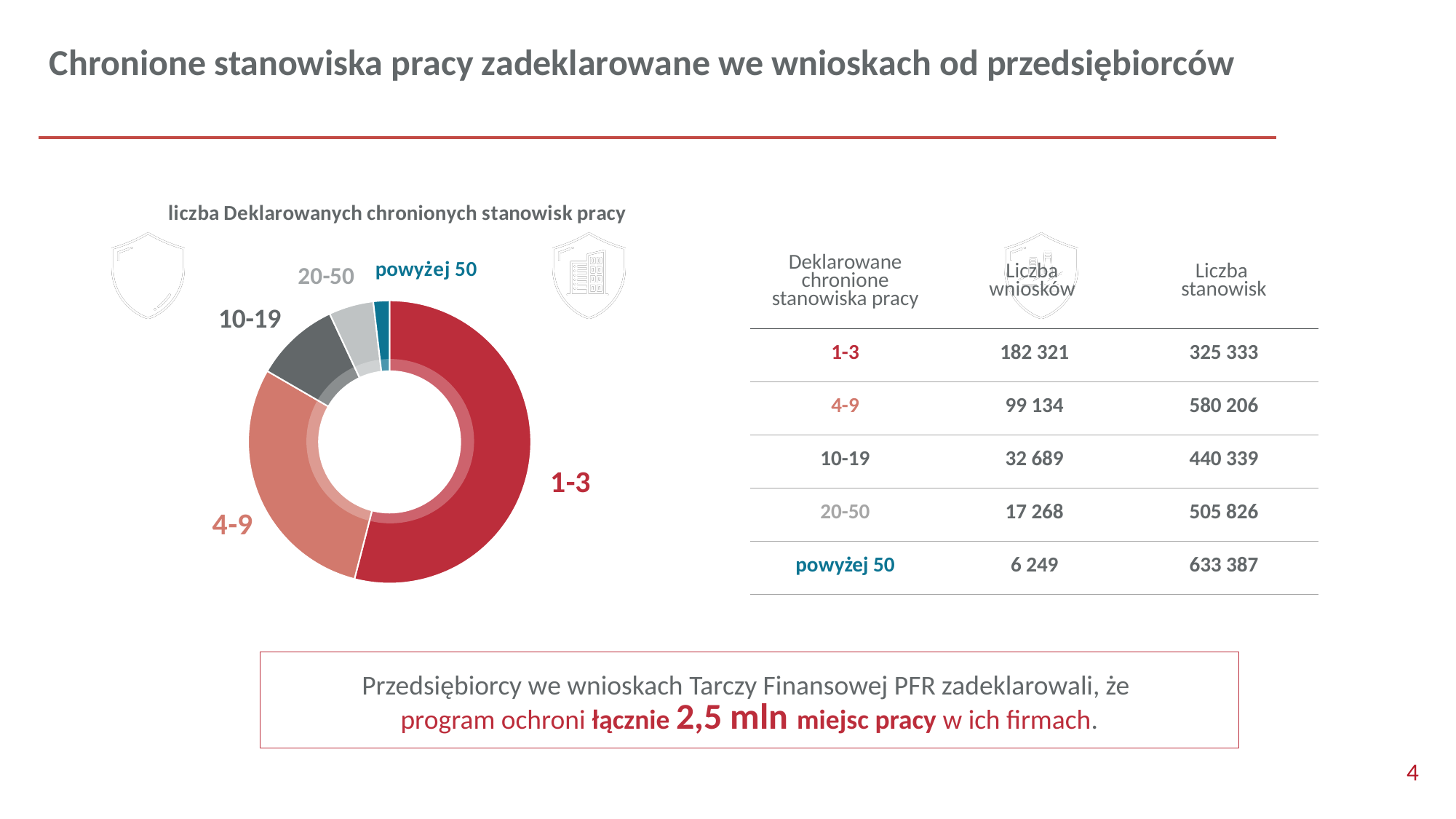
What is the title of the donut chart? liczba Deklarowanych chronionych stanowisk pracy Which slice is larger in the donut chart, 4-9 or 10-19? 4-9 What kind of chart is shown on the slide? Donut (pie) chart What colour is the slice for the 1-3 category in the donut chart? Red How many categories does the donut chart show? 5 Which slice is larger in the donut chart, 20-50 or powyżej 50? 20-50 According to the table on the slide, what is the number of applications (Liczba wniosków) for the powyżej 50 category? 6 249 Which category has the smallest slice in the donut chart? powyżej 50 According to the table on the slide, what is the number of applications (Liczba wniosków) for the 1-3 category? 182 321 According to the table on the slide, what is the number of positions (Liczba stanowisk) for the 4-9 category? 580 206 Which category has the largest slice in the donut chart? 1-3 According to the table on the slide, what is the difference in the number of applications (Liczba wniosków) between the 1-3 and 4-9 categories? 83 187